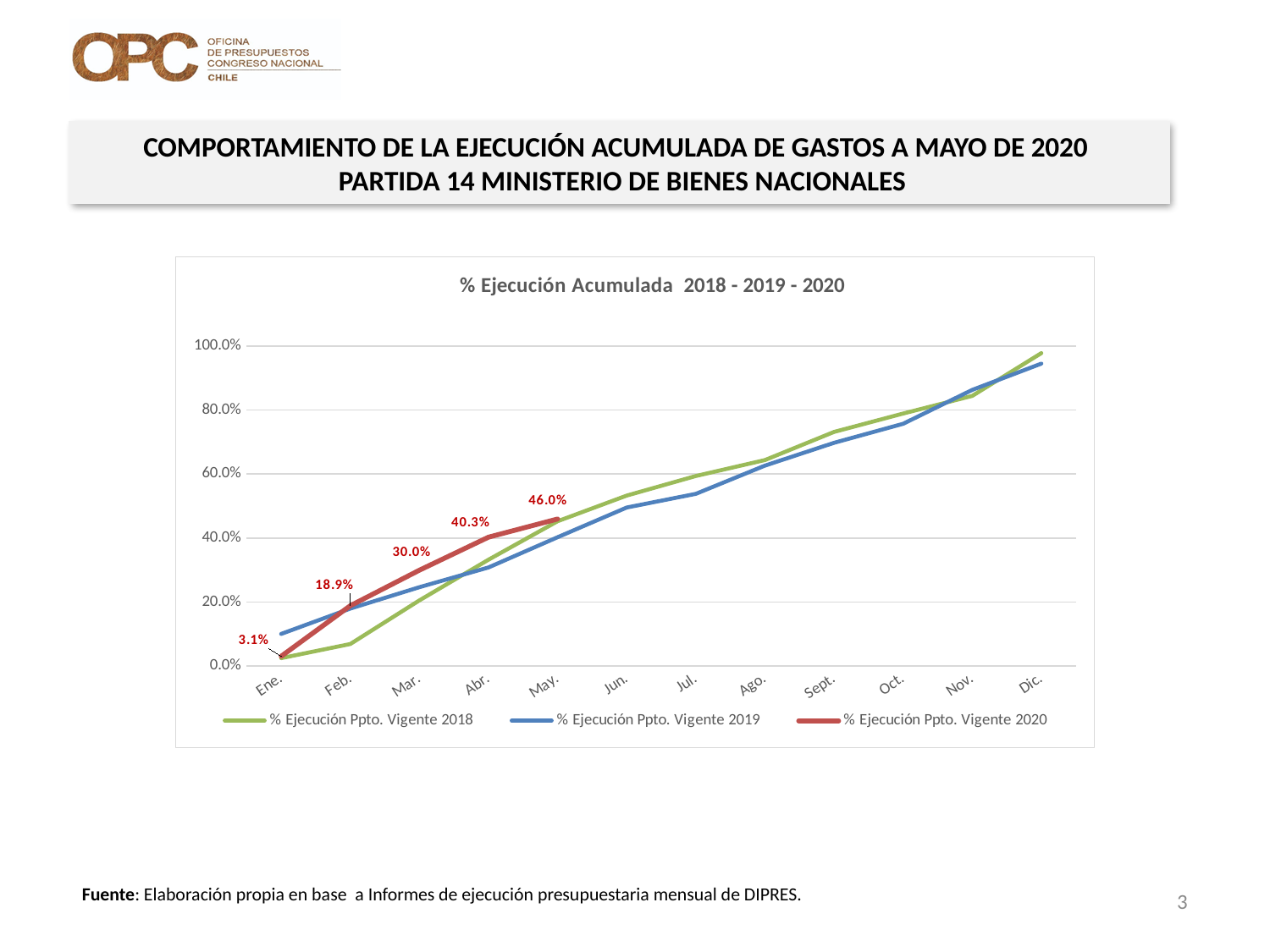
How many months are shown on the x axis? 12 What is the difference between the 2020 values for May. and Abr.? 5.7 percentage points How many series does the legend list? 3 In which month does the % Ejecución Ppto. Vigente 2020 series have its lowest value? Ene. What is the value of % Ejecución Ppto. Vigente 2020 for May.? 46.0% What is the value of % Ejecución Ppto. Vigente 2020 for Feb.? 18.9% What kind of chart is shown? Line chart In Abr., which series is higher: % Ejecución Ppto. Vigente 2020 or % Ejecución Ppto. Vigente 2019? % Ejecución Ppto. Vigente 2020 What is the value of % Ejecución Ppto. Vigente 2020 for Ene.? 3.1% In which month does the % Ejecución Ppto. Vigente 2020 series reach its highest value? May. Is the value for % Ejecución Ppto. Vigente 2018 in Dic. greater or less than 80.0%? greater What is the title of the chart? % Ejecución Acumulada 2018 - 2019 - 2020